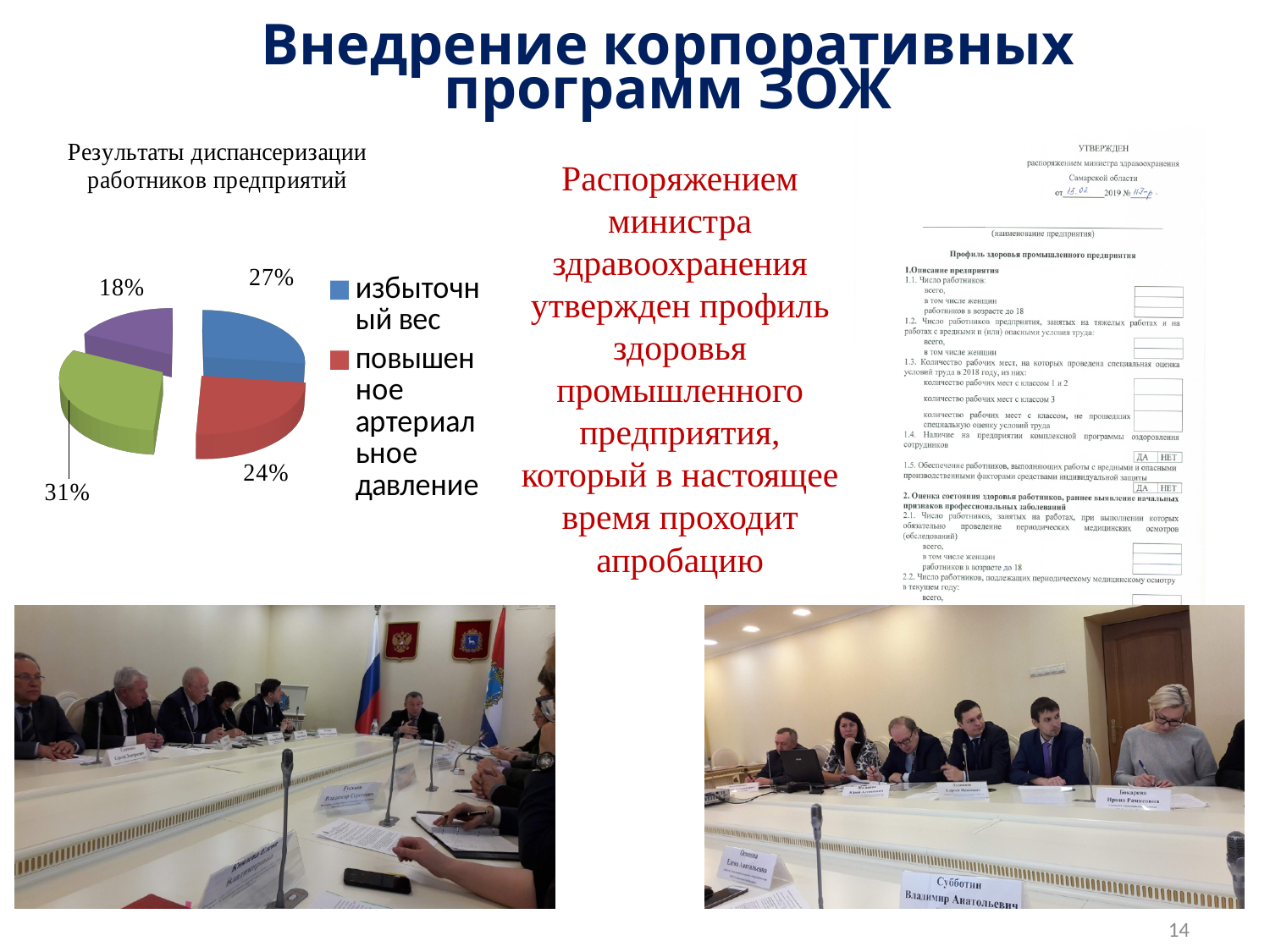
In the pie chart, which is larger: the share for 'избыточный вес' or for 'повышенное артериальное давление'? избыточный вес In the pie chart, what share of the whole does 'повышенное артериальное давление' represent? 24% What type of chart is shown on the slide? Pie chart In the pie chart 'Результаты диспансеризации работников предприятий', what percentage is shown for 'избыточный вес'? 27% In the pie chart, what is the combined share of 'избыточный вес' and 'повышенное артериальное давление'? 51% In the pie chart 'Результаты диспансеризации работников предприятий', what percentage is shown for 'повышенное артериальное давление'? 24% What is the smallest percentage value labelled on the pie chart? 18% What is the title of the pie chart on the slide? Результаты диспансеризации работников предприятий In the pie chart, what is the difference between the share for 'избыточный вес' and the share for 'повышенное артериальное давление'? 3% How many slices does the pie chart on the slide have? 4 In the pie chart, what colour is the slice for 'избыточный вес'? Blue What is the largest percentage value labelled on the pie chart? 31%